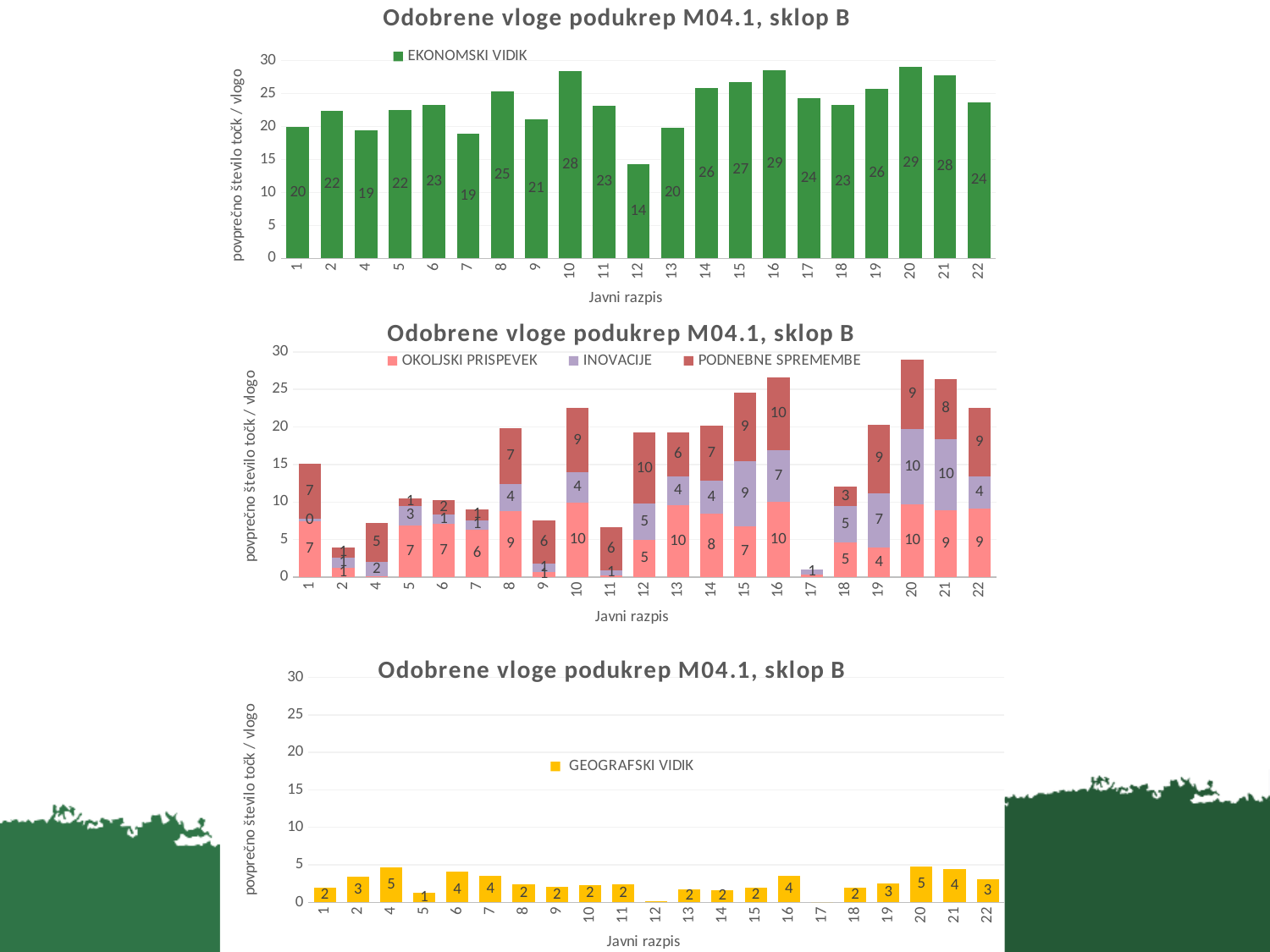
In the top chart, which has the larger value: Javni razpis 10 or Javni razpis 12? 10 In the middle chart, is the total stacked value for Javni razpis 17 greater or less than 5? less How many series does the legend of the middle chart list? 3 In the top chart, what is the value for Javni razpis 12? 14 In the bottom chart, what is the value for Javni razpis 20? 5 What series name is shown in the legend of the bottom chart? GEOGRAFSKI VIDIK What kind of chart is the bottom chart? bar chart In the top chart, which Javni razpis has the lowest value? 12 In the middle chart, what is the PODNEBNE SPREMEMBE value for Javni razpis 16? 10 In the middle chart, what is the INOVACIJE value for Javni razpis 20? 10 In the top chart, what is the difference between the values for Javni razpis 16 and Javni razpis 12? 15 How many categories are shown on the x axis of the top chart? 21